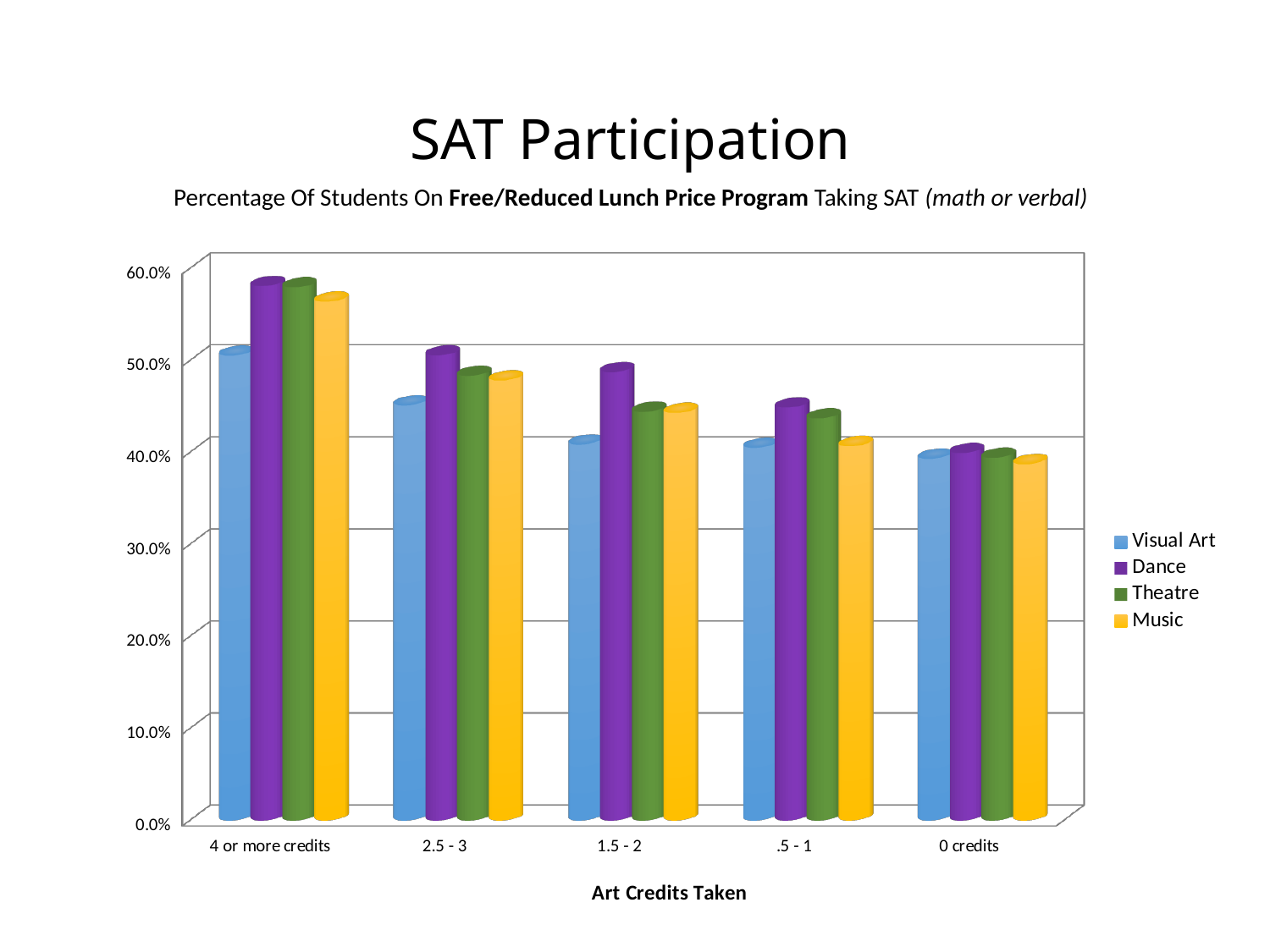
Is the value for Music in the '4 or more credits' category greater or less than 50.0%? greater Is the value for Theatre in the '.5 - 1' category greater or less than 40.0%? greater What kind of chart is shown on the slide? bar chart How many art-credit categories are shown on the x axis? 5 What is the title of the x axis? Art Credits Taken Is the value for Dance in the '4 or more credits' category greater or less than 50.0%? greater How many series does the legend list? 4 In the '1.5 - 2' category, which is larger: Dance or Visual Art? Dance In the '2.5 - 3' category, which series has the highest value? Dance Do the Visual Art values rise or fall moving from '4 or more credits' to '0 credits' along the x axis? fall In the '4 or more credits' category, which series has the lowest value? Visual Art